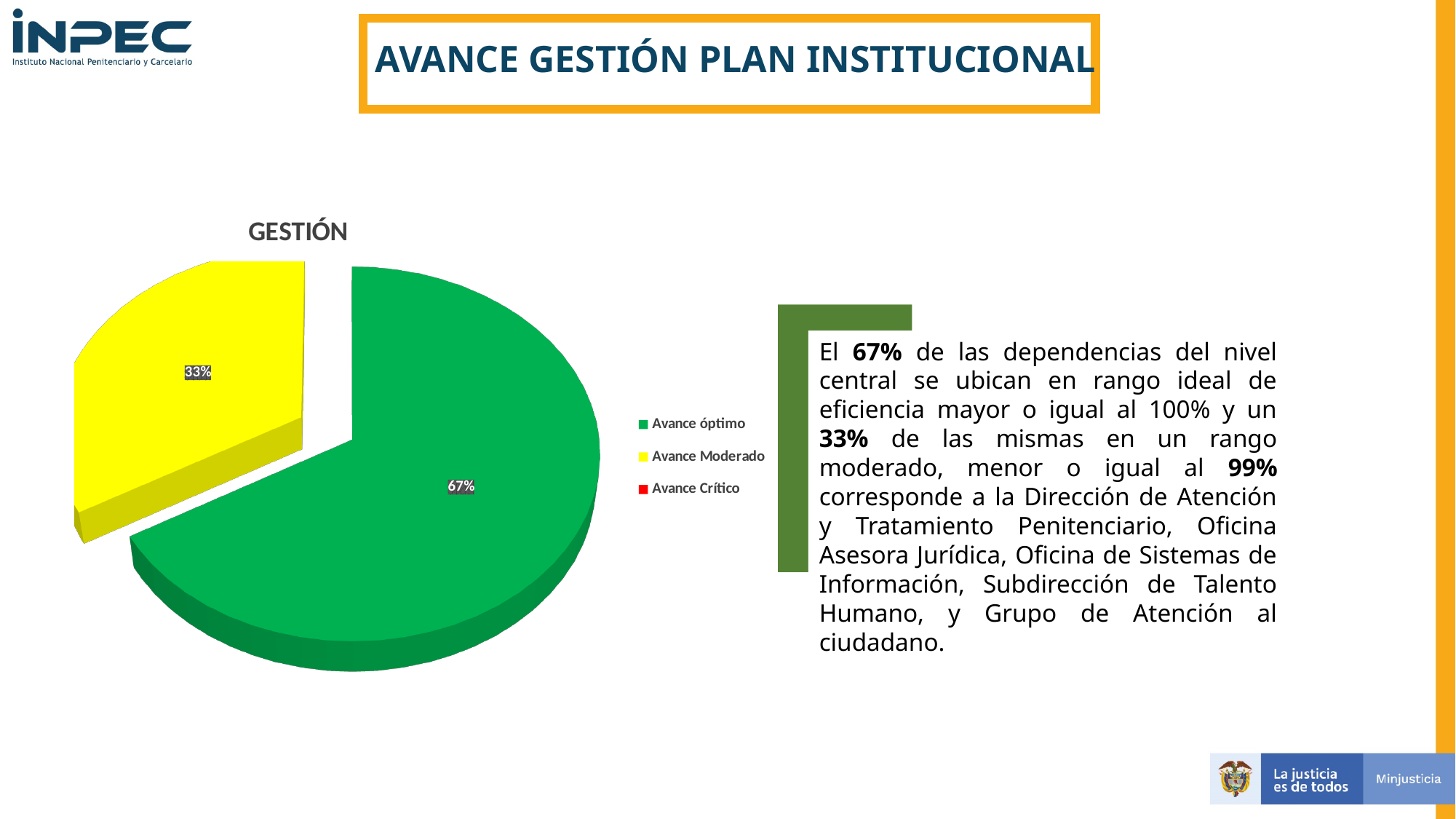
What is the title of the chart? GESTIÓN What percentage does the Avance Moderado slice show? 33% Which of the visible slices is the smallest? Avance Moderado What is the difference in percentage points between the Avance óptimo and Avance Moderado slices? 34 How many entries does the legend list? 3 What colour is the Avance Moderado slice? yellow Which is larger, the Avance óptimo slice or the Avance Moderado slice? Avance óptimo Which category has the largest slice of the pie? Avance óptimo How many slices with data labels are visible in the pie? 2 What type of chart is shown on the slide? pie chart What percentage does the Avance óptimo slice show? 67%